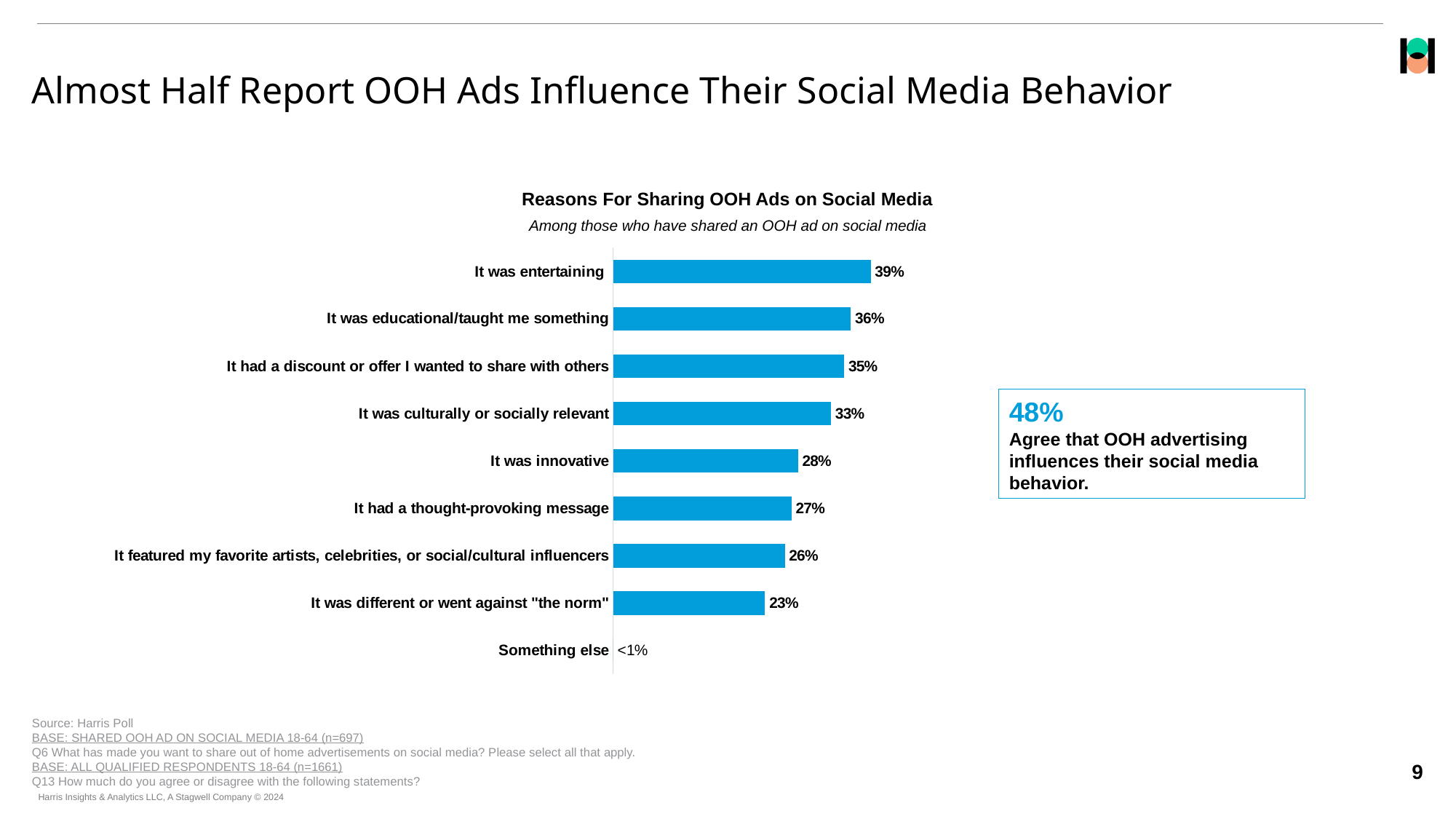
What percentage of respondents said they shared an OOH ad because it was entertaining? 39% What type of chart is used to show the reasons for sharing OOH ads on social media? Bar chart What percentage is shown for "It was different or went against "the norm""? 23% How many reasons (categories) are listed in the chart? 9 What is the value for "It was culturally or socially relevant"? 33% Which reason for sharing OOH ads on social media has the highest percentage? It was entertaining What is the title of the chart? Reasons For Sharing OOH Ads on Social Media Which reason has the lowest percentage? Something else What percentage agree that OOH advertising influences their social media behavior, according to the callout box? 48% What is the difference in percentage points between "It was entertaining" and "It was innovative"? 11 What value is shown for "Something else"? <1% Which is larger: the value for "It had a discount or offer I wanted to share with others" or the value for "It had a thought-provoking message"? It had a discount or offer I wanted to share with others